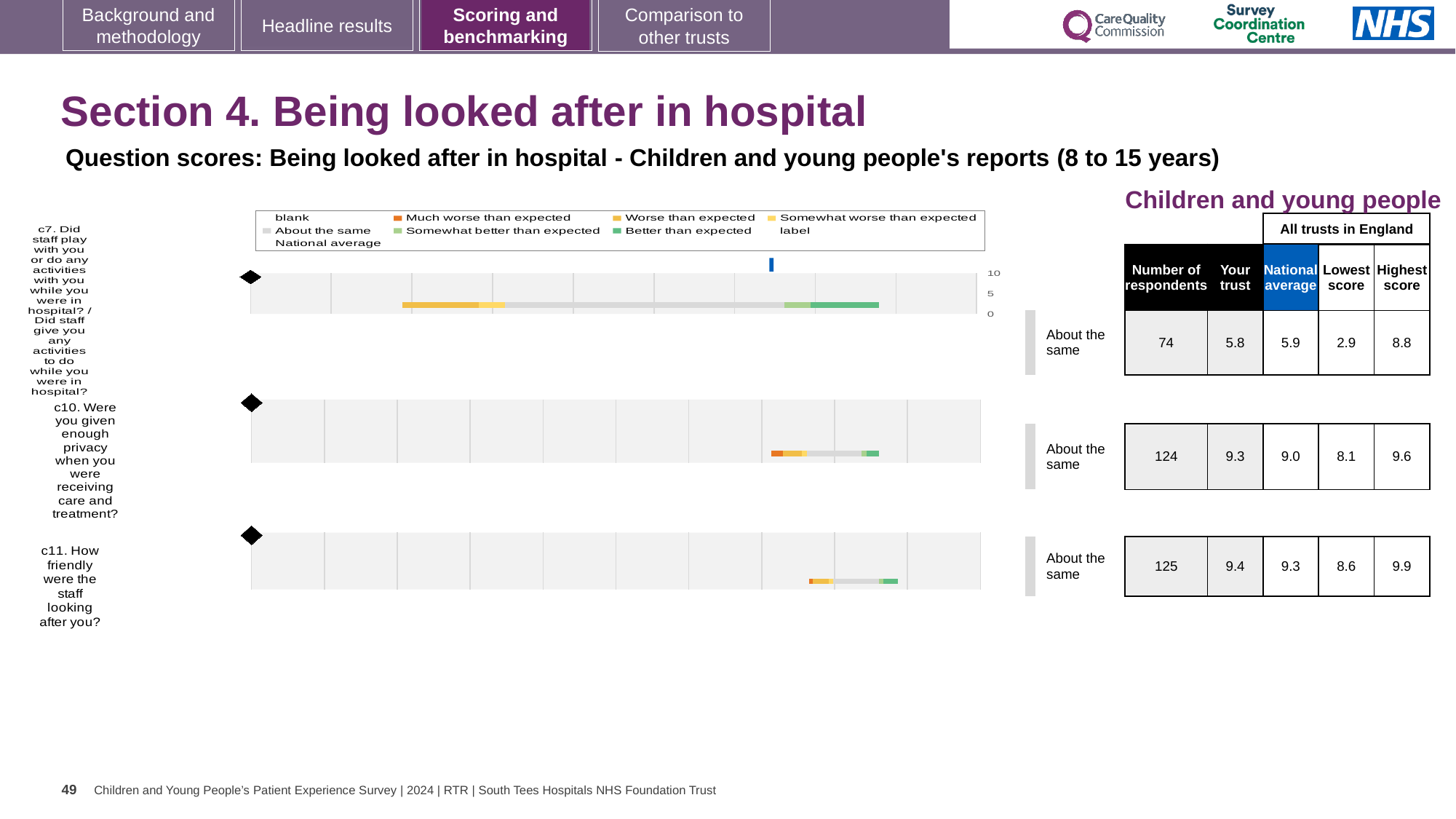
How many survey questions are plotted on the slide? 3 What benchmark category is shown for question c11? About the same How many respondents answered question c11 (How friendly were the staff looking after you?)? 125 What is the difference between the highest score and the lowest score for question c7? 5.9 For question c10, which is larger: the 'Your trust' score or the national average? Your trust What is the highest score across all trusts in England for question c7? 8.8 What kind of chart is used to show the question scores on this slide? bar chart What is the 'Your trust' score for question c7 (Did staff play with you or do any activities with you while you were in hospital?)? 5.8 What is the national average score for question c10 (Were you given enough privacy when you were receiving care and treatment?)? 9.0 Which question has the highest 'Your trust' score? c11. How friendly were the staff looking after you? What is the lowest score across all trusts in England for question c11? 8.6 Which question has the fewest respondents? c7. Did staff play with you or do any activities with you while you were in hospital?